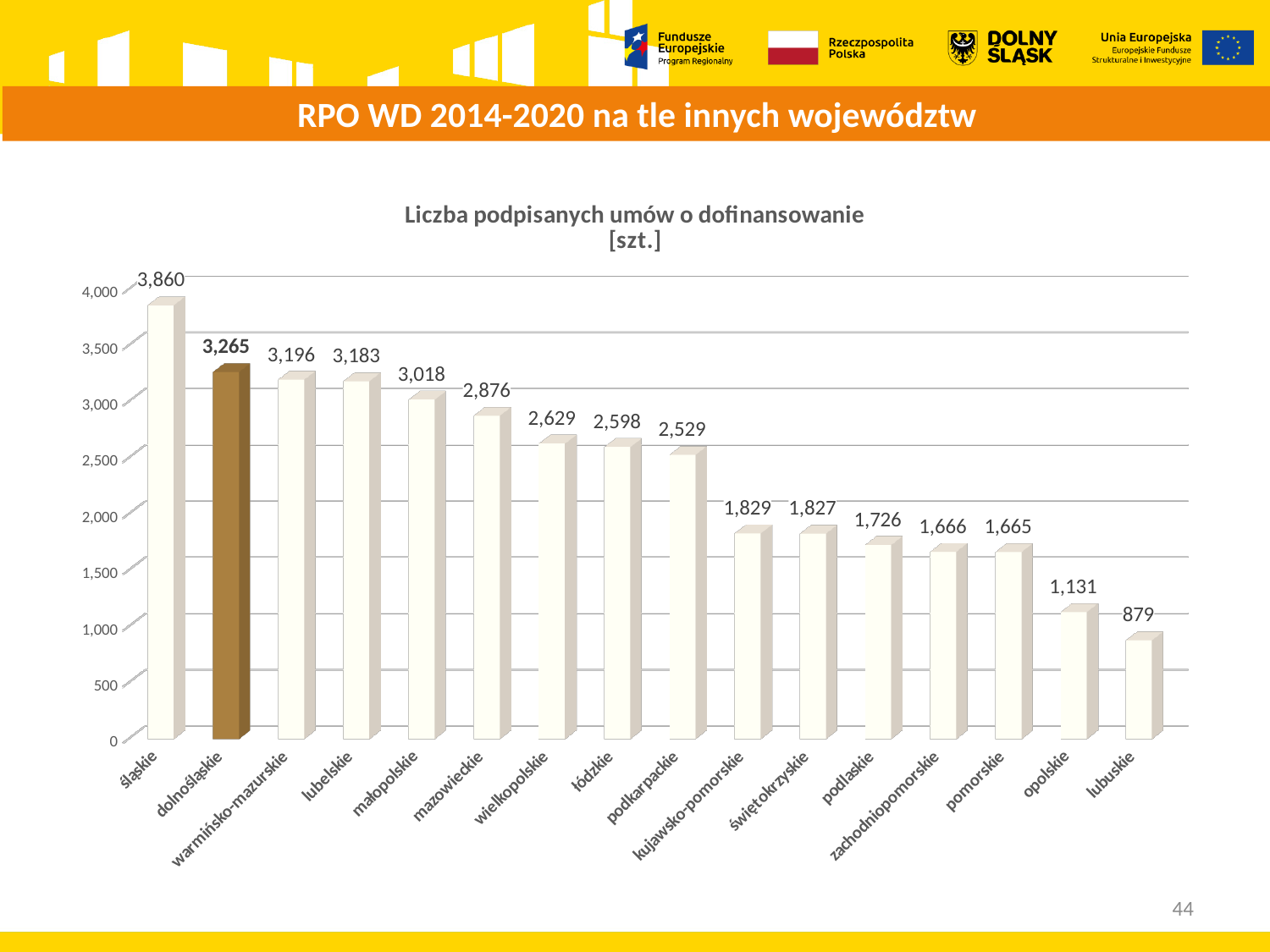
Which is larger, the value for małopolskie or the value for łódzkie? małopolskie How many voivodeships are shown on the chart? 16 What kind of chart is shown on the slide? bar chart What is the difference between the values for śląskie and dolnośląskie? 595 Which voivodeship has the highest number of signed agreements? śląskie Do the values rise or fall from left to right along the x axis? fall Which voivodeship has the lowest number of signed agreements? lubuskie What is the title of the chart? Liczba podpisanych umów o dofinansowanie [szt.] What is the value for mazowieckie? 2,876 What is the value for opolskie? 1,131 What is the value for dolnośląskie? 3,265 Is the value for podkarpackie greater or less than 2,500? greater